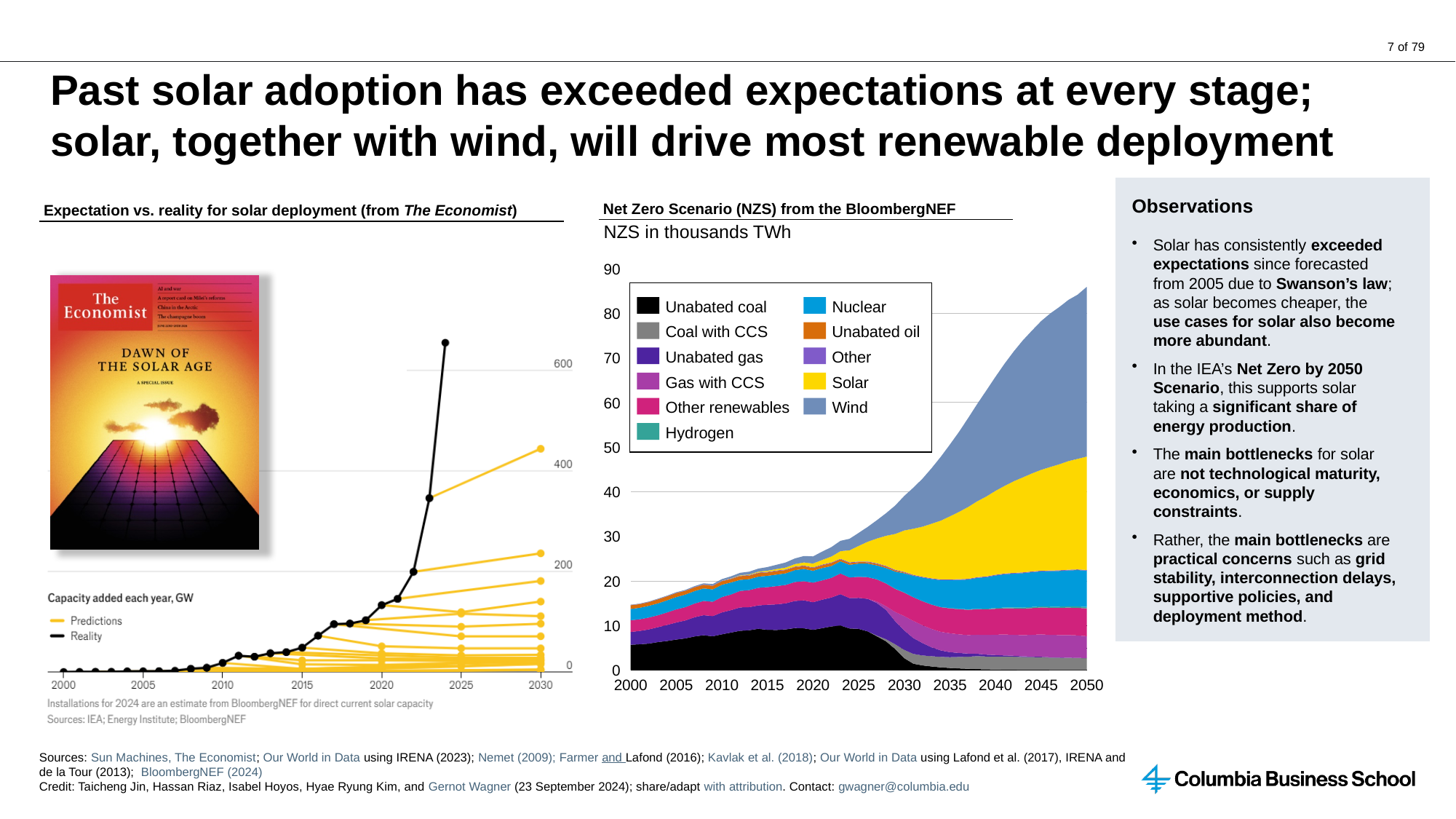
On the Net Zero Scenario chart, does the total stacked value rise or fall between 2030 and 2050? Rise On the Expectation vs. reality chart from The Economist, how many series does the legend list? 2 On the Net Zero Scenario chart, how many series does the legend list? 11 What kind of chart is the Net Zero Scenario (NZS) chart on the right? Stacked area chart On the Expectation vs. reality chart from The Economist, does the Reality line rise or fall from 2000 to 2024? Rise On the Net Zero Scenario chart, is the total stacked value in 2000 greater or less than 20? less On the Net Zero Scenario chart, is the total stacked value in 2050 greater or less than 80? greater On the Net Zero Scenario chart, which series is shown in yellow? Solar On the Net Zero Scenario chart, what unit is given for the values? Thousands TWh On the Net Zero Scenario chart, which is larger in 2050: the Wind area or the Unabated coal area? Wind On the Expectation vs. reality chart from The Economist, is the Reality value for 2024 greater or less than 600? greater